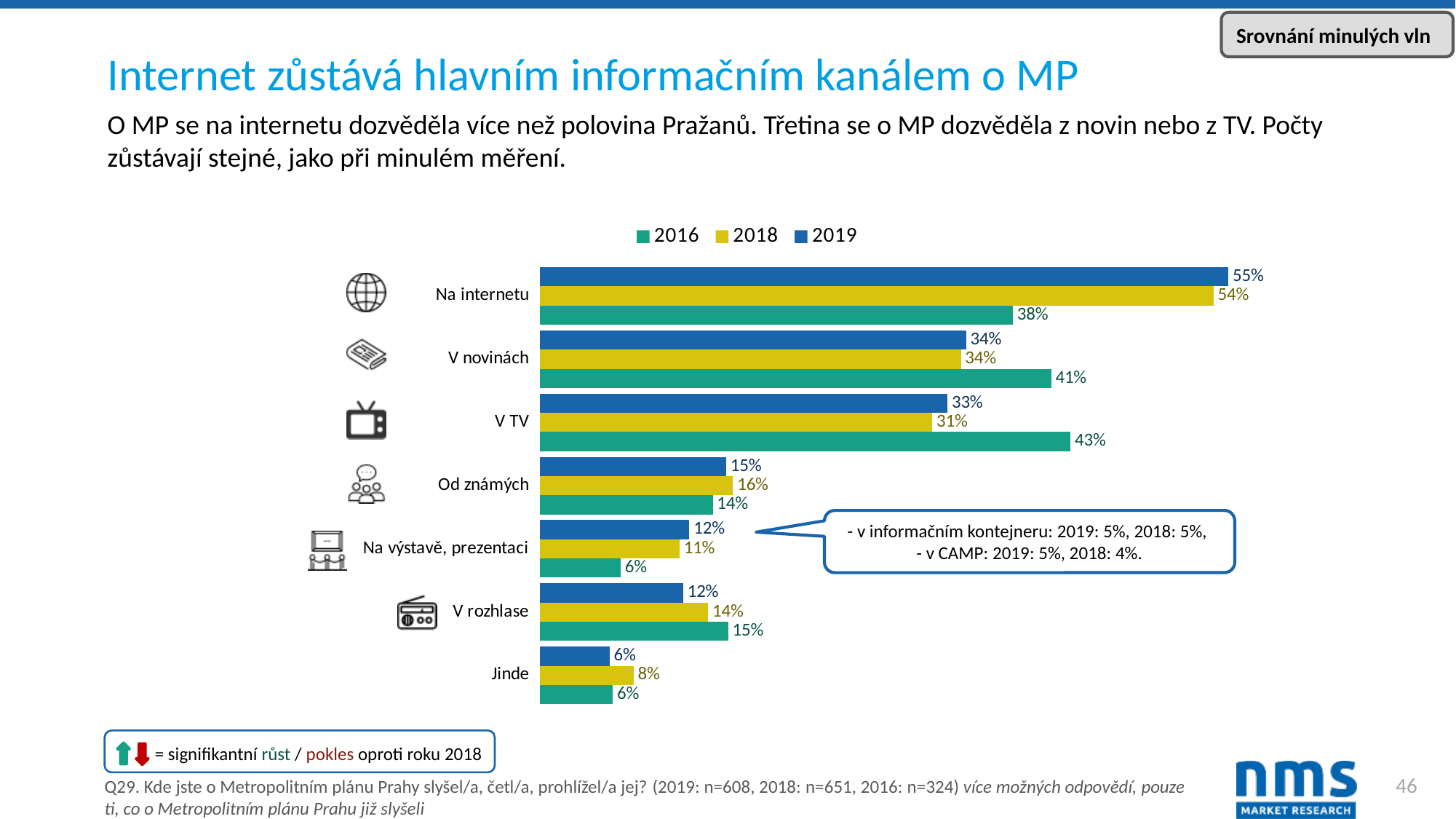
What is the 2018 value for 'V rozhlase'? 14% Which is larger for 'V novinách': the 2016 value or the 2019 value? 2016 What is the difference between the 2018 and 2019 values for 'V TV'? 2% Which category has the highest 2019 value? Na internetu What is the difference between the 2019 and 2016 values for 'Na internetu'? 17% Which legend entry is shown in yellow? 2018 What is the 2019 value for 'Na internetu'? 55% Which category has the lowest 2018 value? Jinde How many series does the legend list? 3 How many categories are shown on the chart? 7 What type of chart is shown on the slide? bar chart What is the 2016 value for 'V TV'? 43%